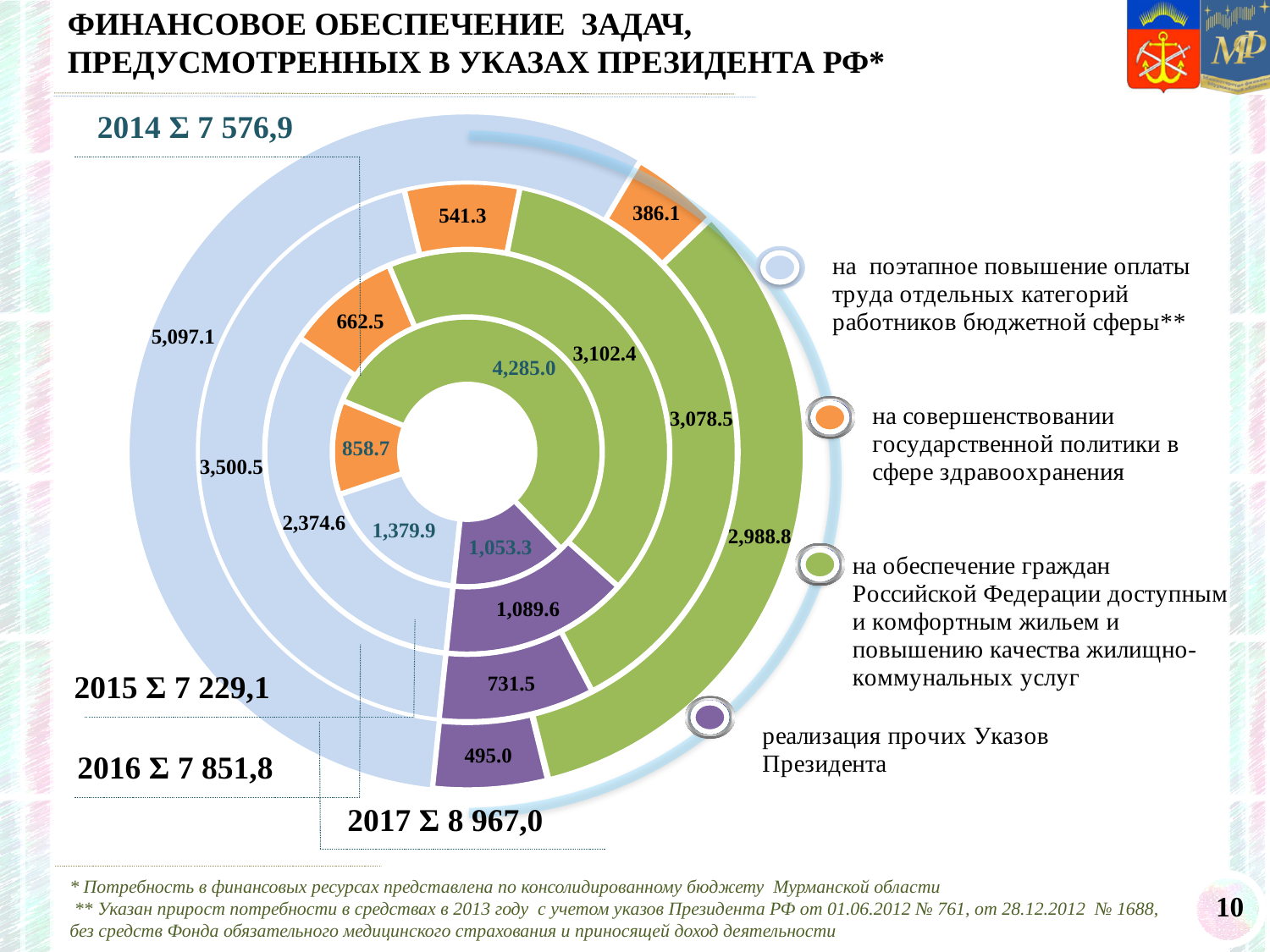
How many categories does the legend list? 4 What is the total (Σ) shown for 2017? 8 967,0 How many years (rings) does the chart show? 4 What is the difference between the light blue (5,097.1) and green (2,988.8) segments in the 2017 ring? 2,108.3 Which segment has the largest value in the outermost 2017 ring? 5,097.1 (light blue, wage increase) What is the value of the green segment (housing and utilities) in the innermost ring for 2014? 4,285.0 Do the orange (healthcare policy) values rise or fall from the 2014 ring to the 2017 ring? fall In the 2015 ring, which is larger: the light blue segment (2,374.6) or the purple segment (1,089.6)? light blue (2,374.6) Which segment has the smallest value in the innermost 2014 ring? 858.7 (orange, healthcare policy) What is the value of the orange segment (healthcare policy) in the outermost ring for 2017? 386.1 What is the value of the purple segment (other Presidential decrees) in the 2016 ring? 731.5 What kind of chart is shown on the slide? doughnut chart